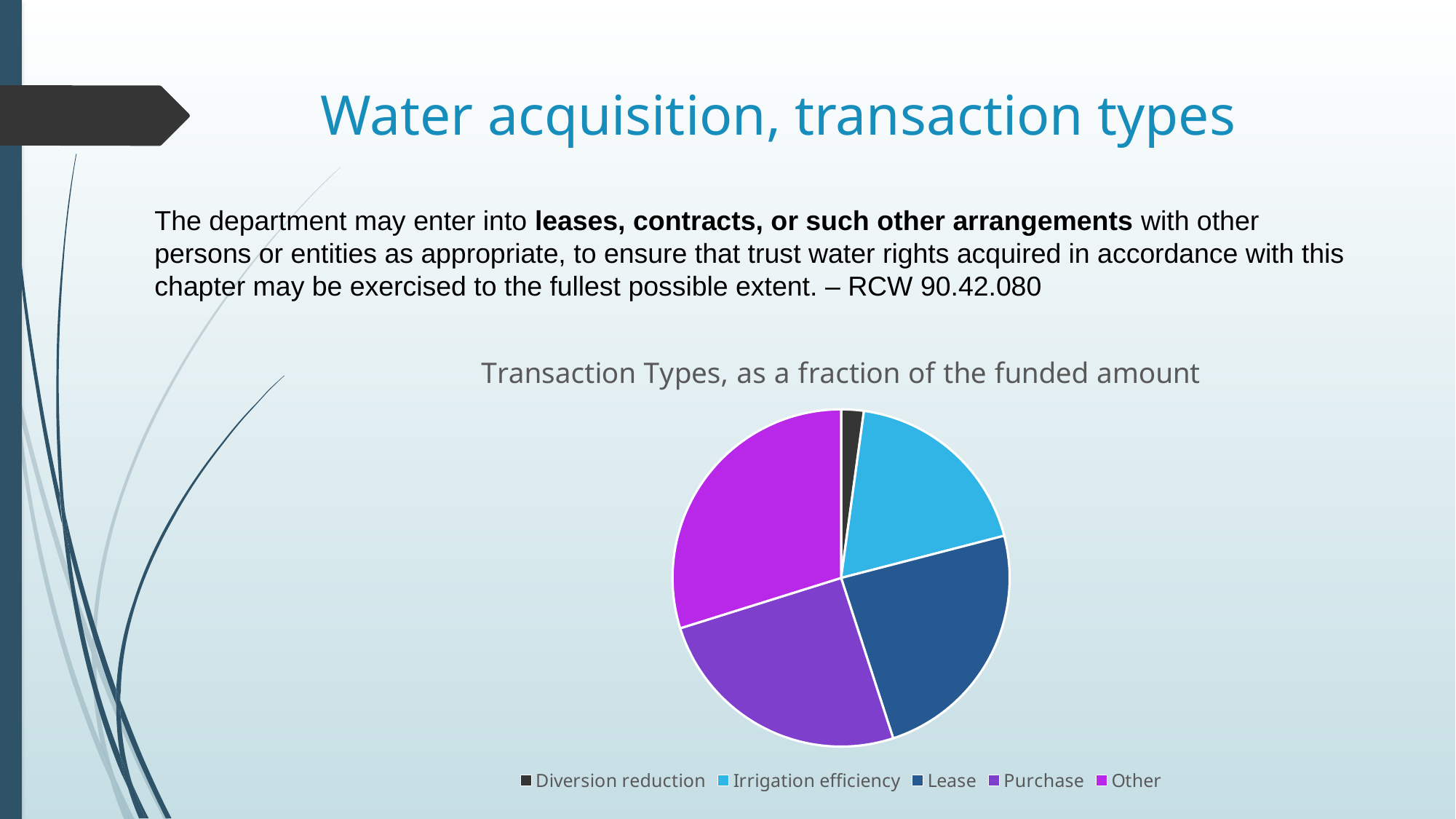
Which transaction type has the largest slice of the pie chart? Other How many slices does the pie chart have? 5 Which transaction type has the smallest slice of the pie chart? Diversion reduction Which slice is larger, Other or Irrigation efficiency? Other What is the title of the pie chart? Transaction Types, as a fraction of the funded amount What kind of chart is shown on the slide? pie chart Which slice is larger, Diversion reduction or Irrigation efficiency? Irrigation efficiency Which slice is larger, Irrigation efficiency or Lease? Lease What colour is the Diversion reduction slice in the pie chart? dark grey How many entries does the legend of the pie chart list? 5